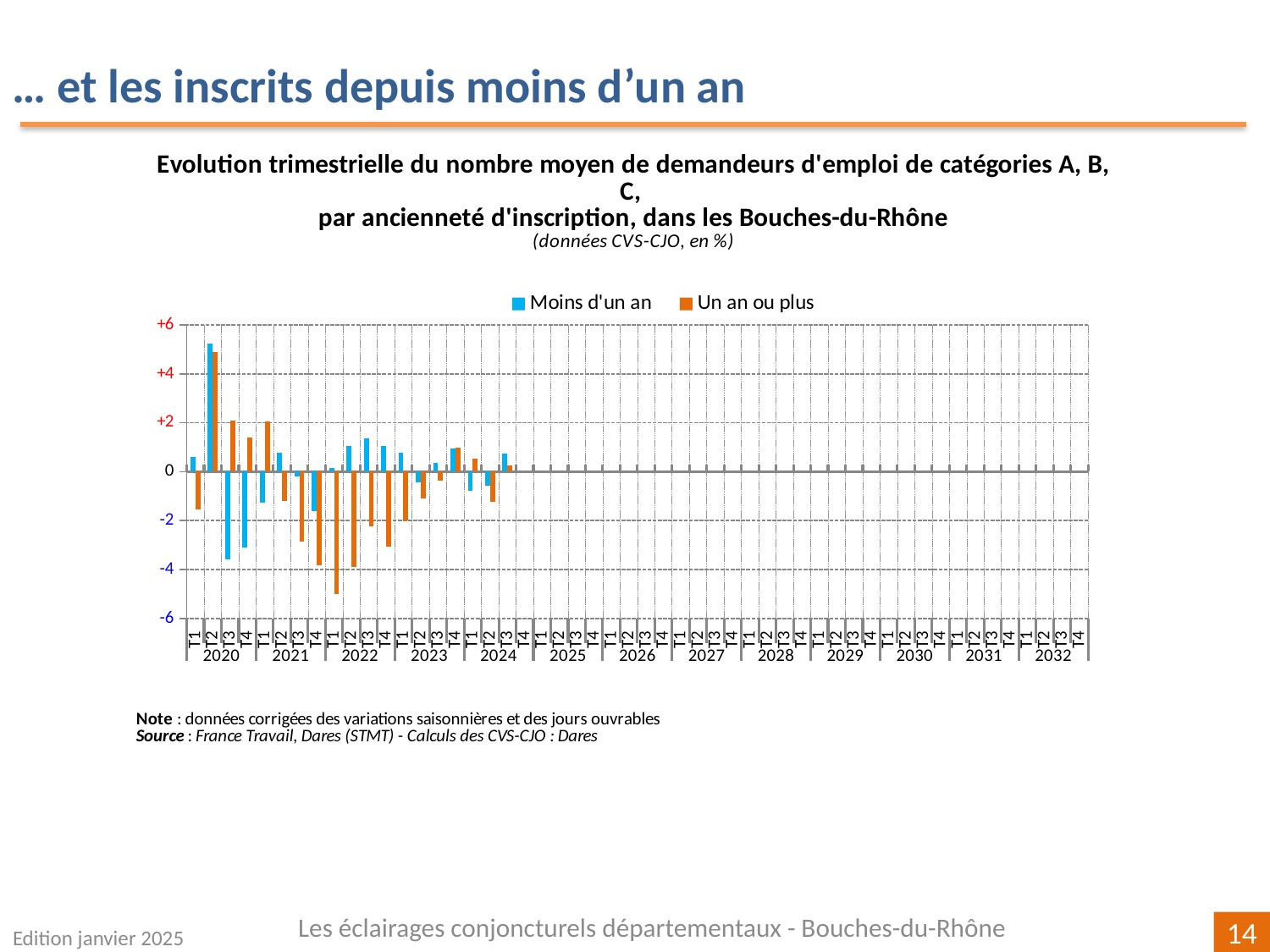
Is the value for 'Moins d'un an' in T2 2020 greater or less than +4? greater Is the value for 'Un an ou plus' in T1 2022 greater or less than -4? less In which quarter does the 'Un an ou plus' series reach its highest value? T2 2020 In which quarter does the 'Un an ou plus' series reach its lowest value? T1 2022 What kind of chart is shown on the slide? bar chart In which quarter does the 'Moins d'un an' series reach its lowest value? T3 2020 What are the two series named in the legend? Moins d'un an; Un an ou plus How many series does the legend list? 2 Is the value for 'Moins d'un an' in T3 2020 greater or less than -2? less In T3 2020, which series has the larger value, 'Moins d'un an' or 'Un an ou plus'? Un an ou plus Which colour represents the series 'Un an ou plus'? orange In which quarter does the 'Moins d'un an' series reach its highest value? T2 2020